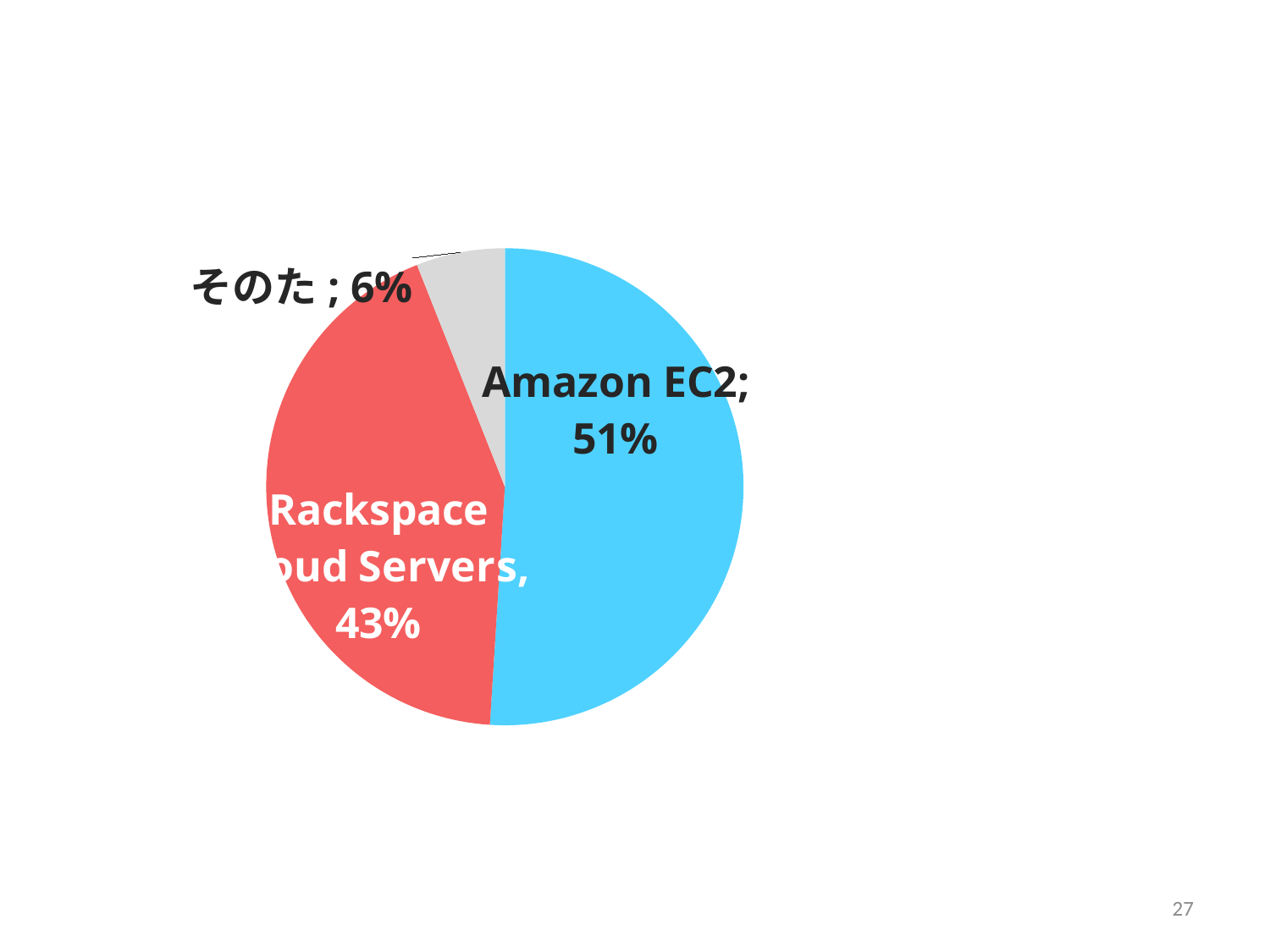
What kind of chart is shown on the slide? Pie chart Which slice of the pie is the smallest? そのた What share of the pie does Amazon EC2 hold? 51% How many slices does the pie chart have? 3 What colour is the Rackspace Cloud Servers slice? Red What percentage is shown for そのた? 6% What is the combined percentage of Amazon EC2 and Rackspace Cloud Servers? 94% What is the difference in percentage points between Amazon EC2 and Rackspace Cloud Servers? 8 What colour is the Amazon EC2 slice? Blue Which is larger, the share for Rackspace Cloud Servers or the share for そのた? Rackspace Cloud Servers Which slice of the pie is the largest? Amazon EC2 What percentage is shown for Rackspace Cloud Servers? 43%